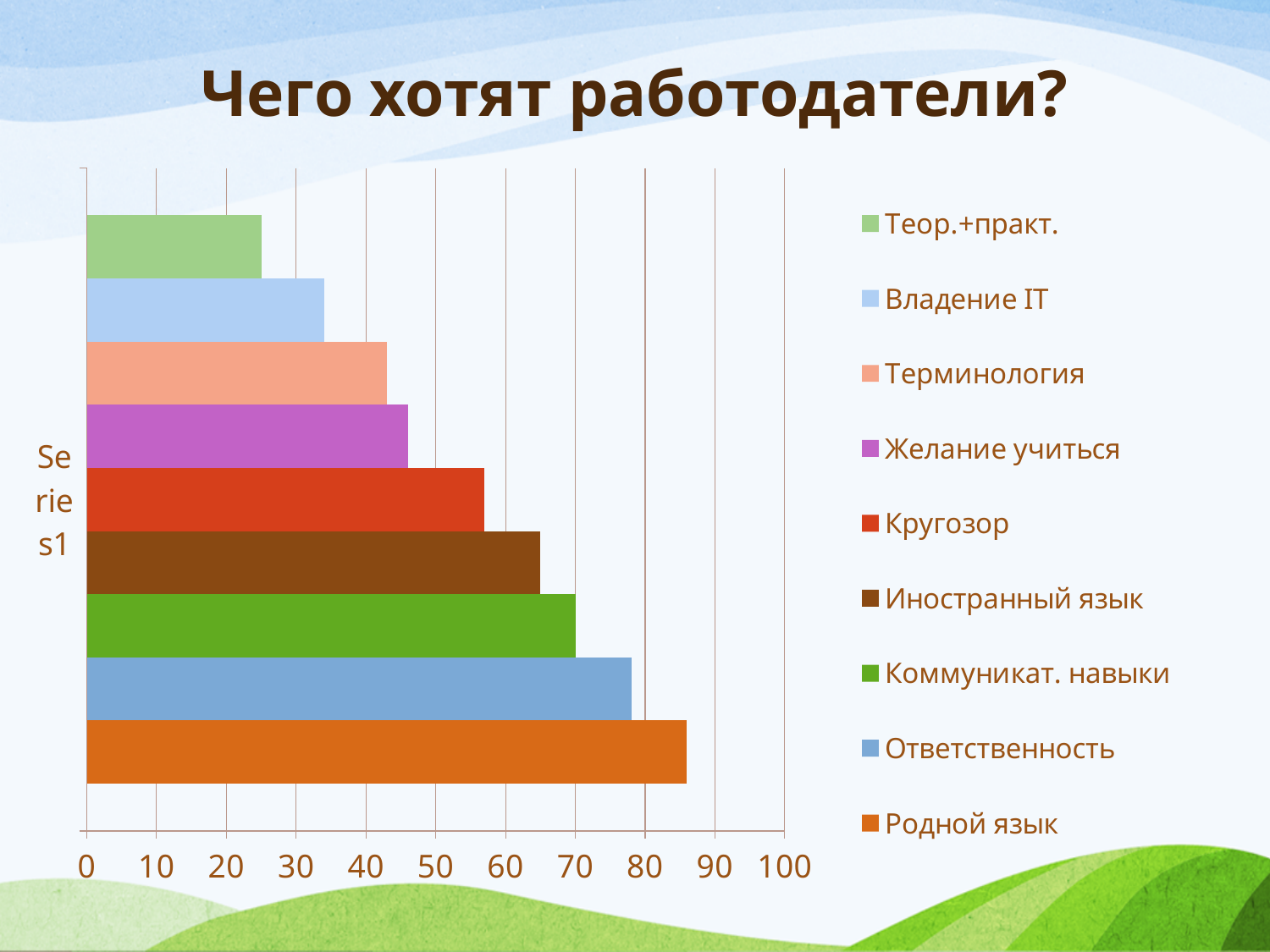
Which is larger, the value for Ответственность or the value for Кругозор? Ответственность Is the value for Теор.+практ. greater or less than 30? less Which legend entry has the shortest bar? Теор.+практ. Which is larger, the value for Терминология or the value for Коммуникат. навыки? Коммуникат. навыки Which legend entry has the longest bar? Родной язык What colour is the bar for Родной язык? orange What kind of chart is shown on the slide? bar chart What is the title of the chart on the slide? Чего хотят работодатели? Is the value for Владение IT greater or less than 40? less How many entries does the chart's legend list? 9 Is the value for Родной язык greater or less than 80? greater